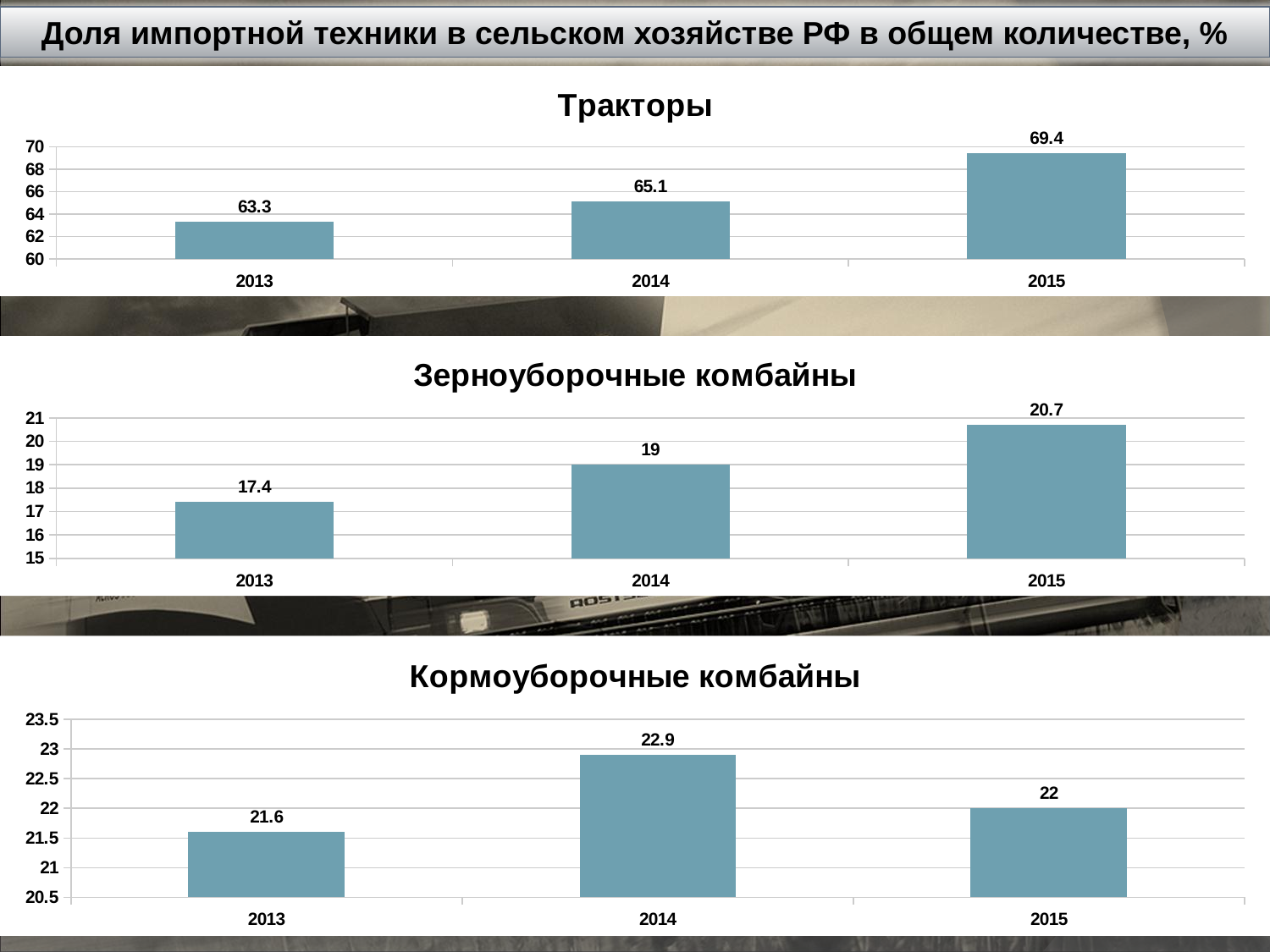
In the 'Зерноуборочные комбайны' chart, what is the value for 2014? 19 In the 'Кормоуборочные комбайны' chart, what is the value for 2013? 21.6 In the 'Тракторы' chart, do the values rise or fall from 2013 to 2015? rise In the 'Тракторы' chart, what is the difference between the 2015 and 2013 values? 6.1 In the 'Зерноуборочные комбайны' chart, what is the difference between the 2014 and 2013 values? 1.6 What type of chart is the 'Тракторы' chart? bar chart In the 'Тракторы' chart, which year has the lowest value? 2013 In the 'Зерноуборочные комбайны' chart, which year has the highest value? 2015 In the 'Кормоуборочные комбайны' chart, which is larger, the value for 2014 or the value for 2015? 2014 In the 'Кормоуборочные комбайны' chart, which year has the highest value? 2014 In the 'Тракторы' chart, what is the value for 2015? 69.4 How many bars are in the 'Кормоуборочные комбайны' chart? 3